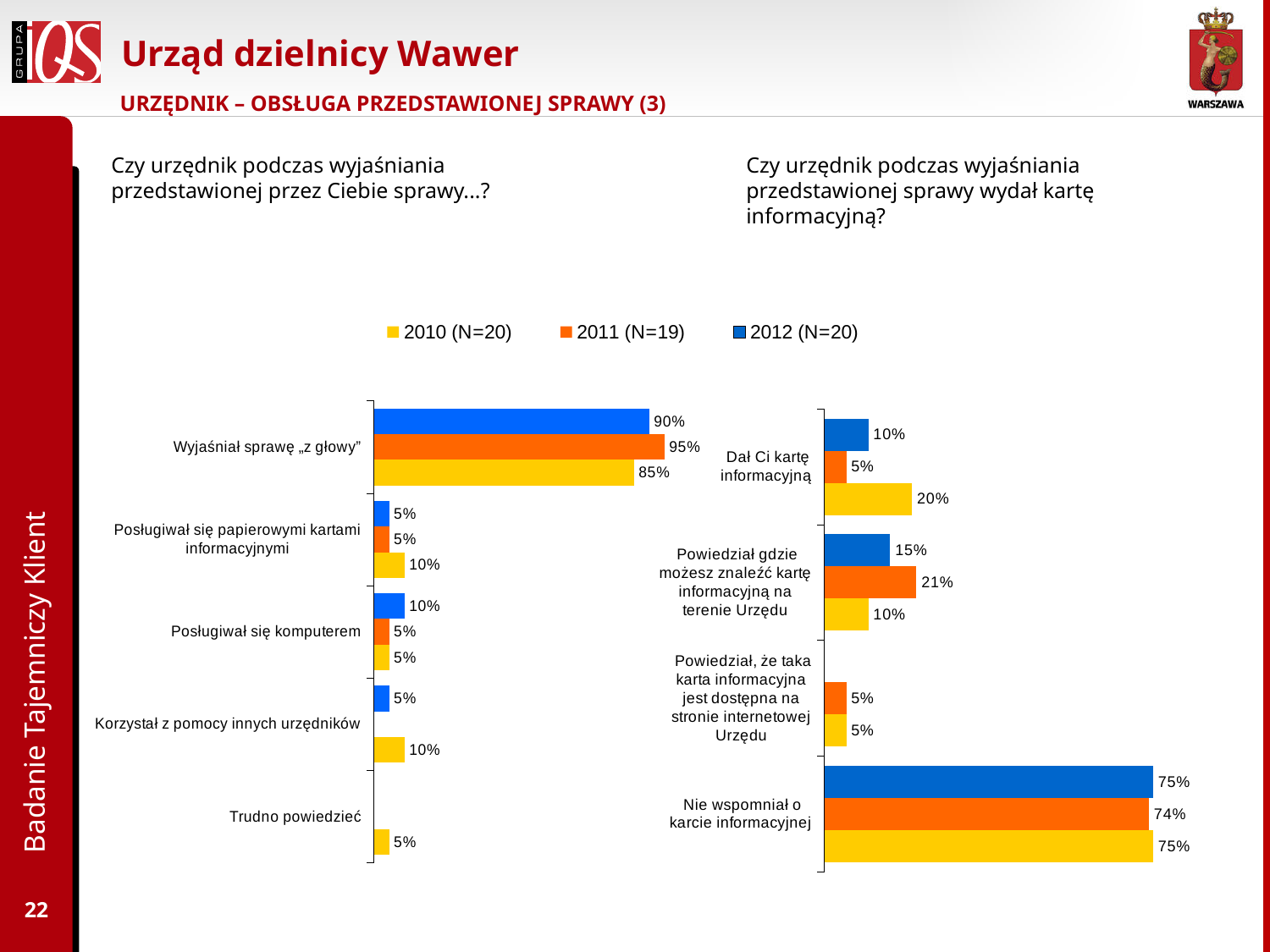
In the left chart, what is the value for "Korzystał z pomocy innych urzędników" in 2010 (N=20)? 10% In the right chart, which is larger for "Dał Ci kartę informacyjną": the 2010 value or the 2012 value? 2010 In the right chart, what is the value for "Powiedział gdzie możesz znaleźć kartę informacyjną na terenie Urzędu" in 2011 (N=19)? 21% How many series does the legend list? 3 In the left chart, which category has the highest value for 2012 (N=20)? Wyjaśniał sprawę „z głowy” In the left chart (Czy urzędnik podczas wyjaśniania przedstawionej przez Ciebie sprawy...?), what is the value for "Wyjaśniał sprawę „z głowy”" in 2011 (N=19)? 95% What kind of chart is the left chart? Bar chart In the left chart, what is the difference between the 2011 and 2010 values for "Wyjaśniał sprawę „z głowy”"? 10% In the right chart (Czy urzędnik podczas wyjaśniania przedstawionej sprawy wydał kartę informacyjną?), what is the value for "Dał Ci kartę informacyjną" in 2010 (N=20)? 20% In the right chart, what is the value for "Nie wspomniał o karcie informacyjnej" in 2011 (N=19)? 74% In the right chart, which category has the highest value for 2010 (N=20)? Nie wspomniał o karcie informacyjnej In the left chart, what is the value for "Posługiwał się komputerem" in 2012 (N=20)? 10%